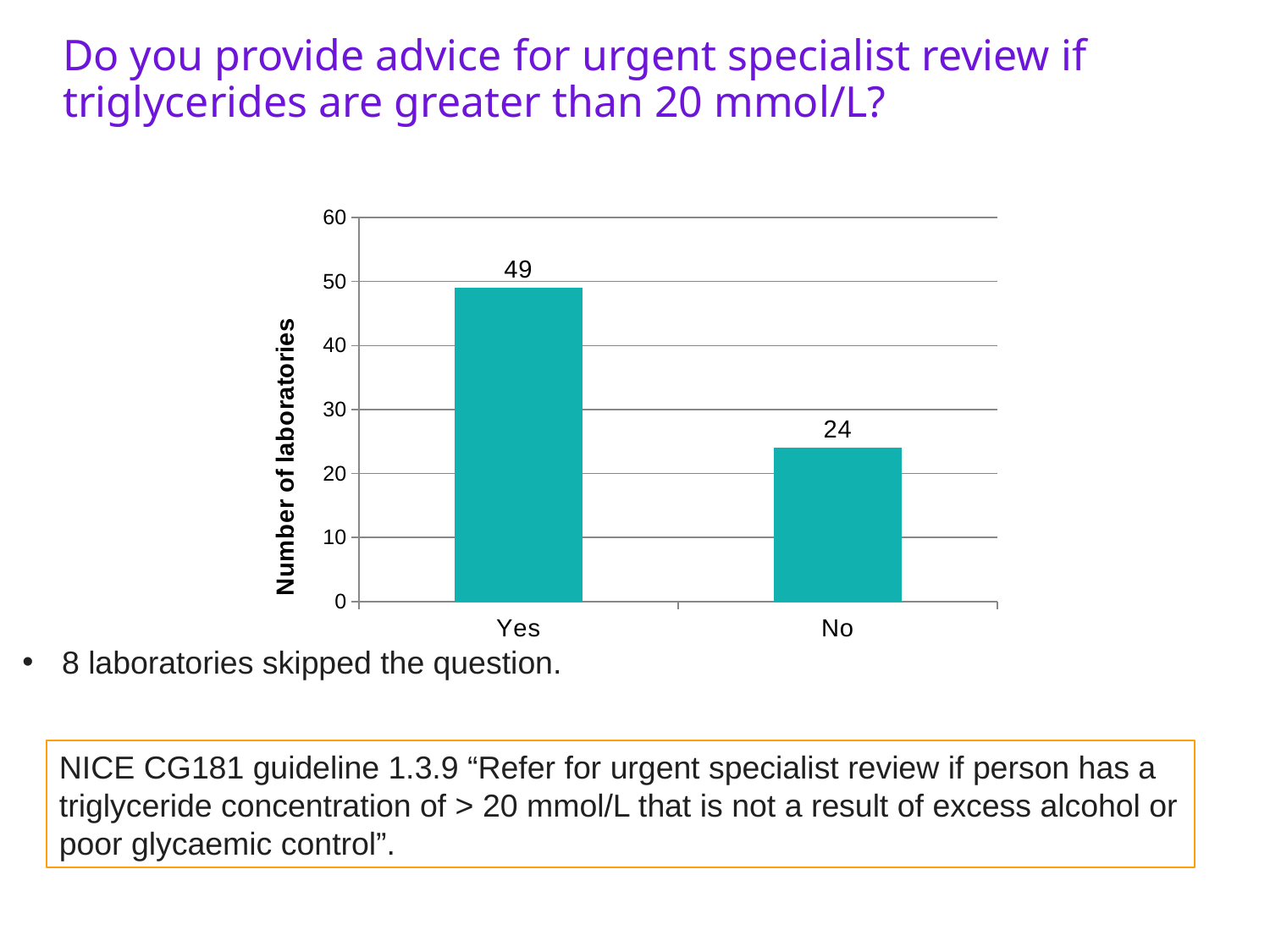
Which category has the lower number of laboratories? No What kind of chart is shown on the slide? Bar chart Which category has the higher number of laboratories? Yes Is the value for Yes greater or less than 40? greater How many categories are shown on the x axis? 2 Is the value for Yes larger than the value for No? Yes How many laboratories answered No? 24 How many laboratories answered Yes? 49 What is the maximum value shown on the vertical axis? 60 Is the value for No greater or less than 30? less What is the difference between the number of laboratories answering Yes and No? 25 What is the label of the vertical axis? Number of laboratories